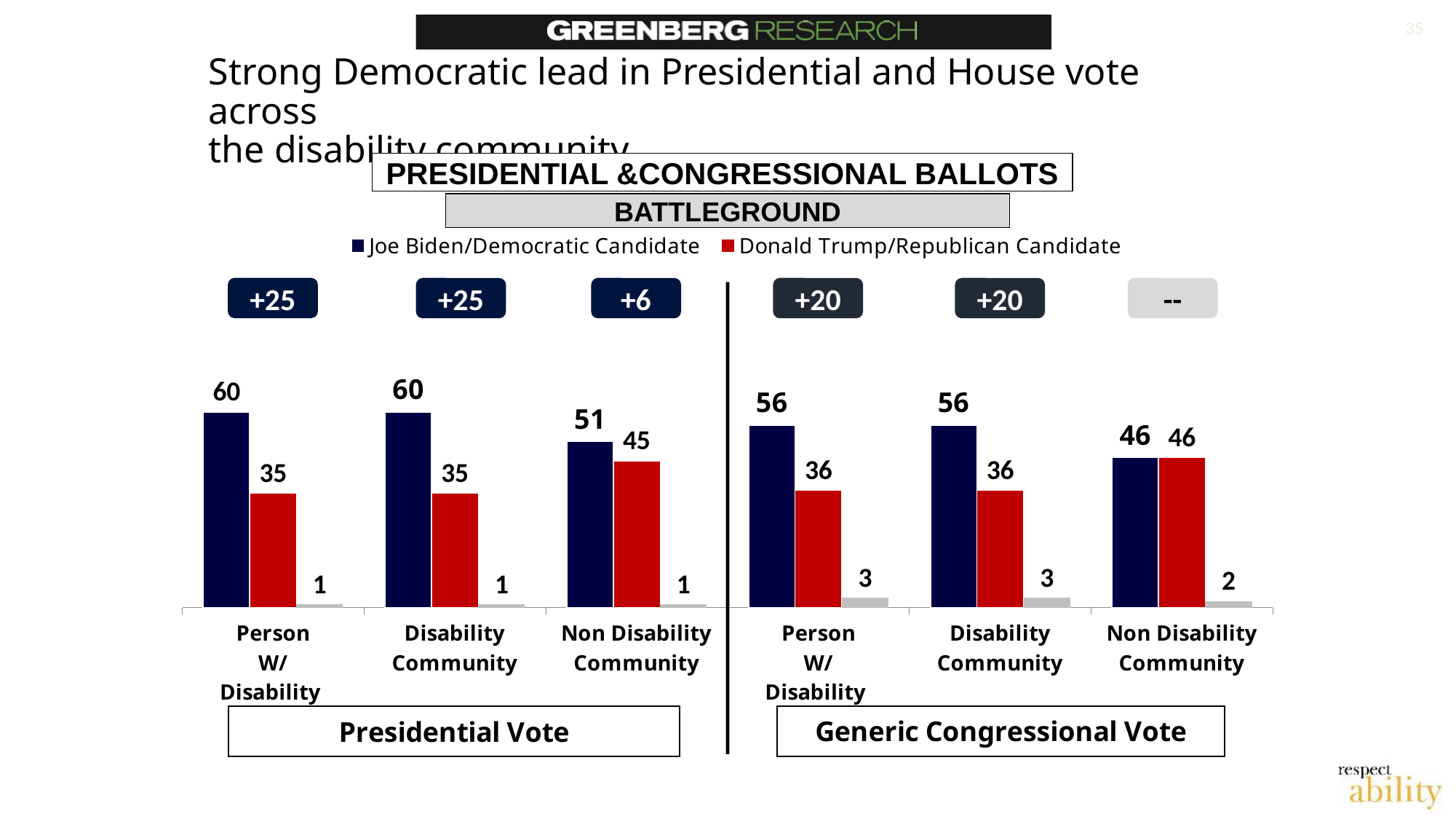
How many series does the legend list? 2 In the Generic Congressional Vote section, what is the value for Donald Trump/Republican Candidate among Person W/ Disability? 36 In the Presidential Vote section, what is the difference between the Joe Biden/Democratic Candidate and Donald Trump/Republican Candidate values for the Disability Community? 25 What kind of chart is shown on the slide? Bar chart In the Generic Congressional Vote section, which is larger for the Non Disability Community: the Joe Biden/Democratic Candidate value or the Donald Trump/Republican Candidate value? They are equal (46) In the Presidential Vote section, which category has the lowest Joe Biden/Democratic Candidate value? Non Disability Community In the Presidential Vote section, what is the value for Donald Trump/Republican Candidate in the Non Disability Community? 45 In the Presidential Vote section, what is the value for Joe Biden/Democratic Candidate among Person W/ Disability? 60 In the Presidential Vote section, which category has the highest Donald Trump/Republican Candidate value? Non Disability Community In the Generic Congressional Vote section, what is the value for Joe Biden/Democratic Candidate in the Disability Community? 56 What is the margin shown above the Non Disability Community group in the Presidential Vote section? +6 How many categories are shown in the Generic Congressional Vote section? 3